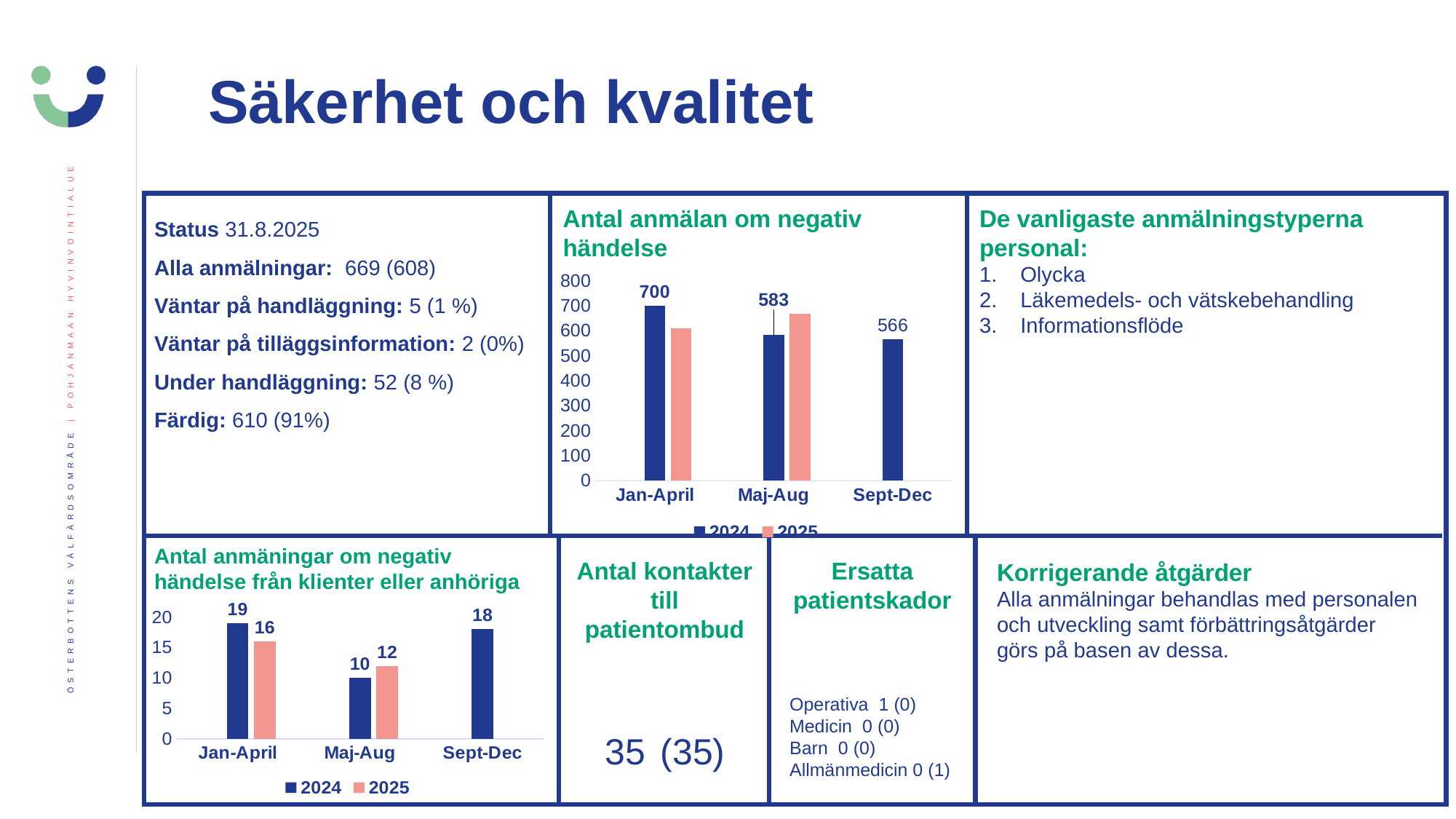
In the chart 'Antal anmälan om negativ händelse', is the 2025 value for Maj-Aug greater or less than 600? greater What kind of chart is 'Antal anmäningar om negativ händelse från klienter eller anhöriga'? bar chart In the chart 'Antal anmäningar om negativ händelse från klienter eller anhöriga', what is the difference between the 2024 and 2025 values for Jan-April? 3 In the chart 'Antal anmäningar om negativ händelse från klienter eller anhöriga', which is larger for Jan-April, the 2024 value or the 2025 value? 2024 In the chart 'Antal anmäningar om negativ händelse från klienter eller anhöriga', what is the 2024 value for Sept-Dec? 18 In the chart 'Antal anmäningar om negativ händelse från klienter eller anhöriga', what is the 2025 value for Maj-Aug? 12 In the chart 'Antal anmälan om negativ händelse', what is the 2024 value for Jan-April? 700 In the chart 'Antal anmälan om negativ händelse', which period has the highest 2024 value? Jan-April In the chart 'Antal anmälan om negativ händelse', what is the difference between the 2024 values for Jan-April and Maj-Aug? 117 In the chart 'Antal anmälan om negativ händelse', how many series does the legend list? 2 In the chart 'Antal anmälan om negativ händelse', what is the 2024 value for Sept-Dec? 566 In the chart 'Antal anmäningar om negativ händelse från klienter eller anhöriga', which period has the lowest 2024 value? Maj-Aug